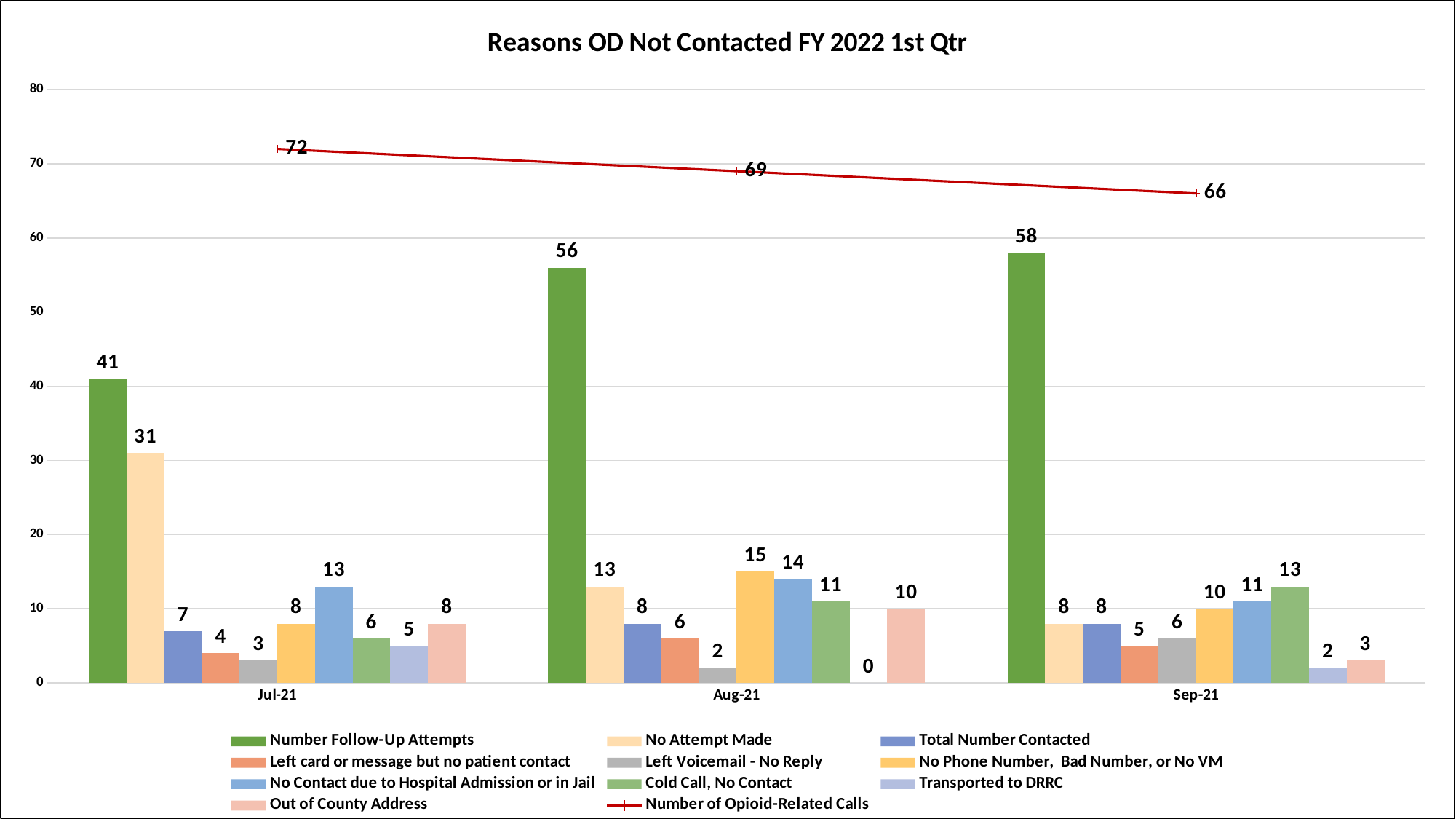
What is the value of Transported to DRRC for Aug-21? 0 In which month is the Number of Opioid-Related Calls lowest? Sep-21 What is the Number of Opioid-Related Calls for Jul-21? 72 What is the value of Number Follow-Up Attempts for Aug-21? 56 Does the Number of Opioid-Related Calls rise or fall from Jul-21 to Sep-21? fall What is the value of No Attempt Made for Jul-21? 31 How many months are shown on the x axis? 3 Which is larger: No Attempt Made in Jul-21 or No Attempt Made in Aug-21? Jul-21 In which month is Number Follow-Up Attempts highest? Sep-21 What is the title of the chart? Reasons OD Not Contacted FY 2022 1st Qtr How many series does the legend list? 11 What is the difference between Number Follow-Up Attempts in Sep-21 and Jul-21? 17